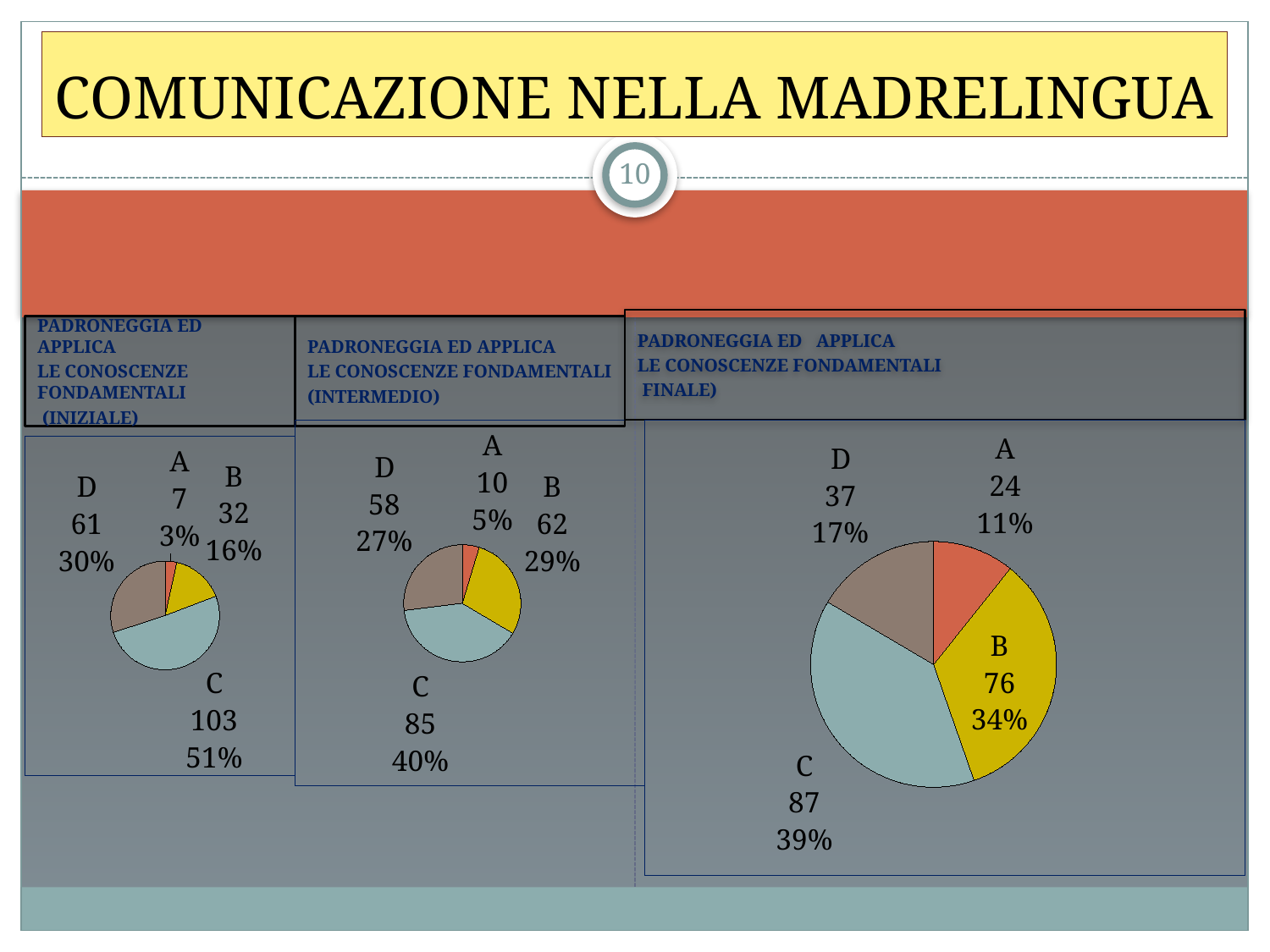
In the left pie chart (INIZIALE), what share of the pie does category D represent? 30% In the middle pie chart (INTERMEDIO), which category has the smallest value? A How many categories does the right pie chart (FINALE) show? 4 In the left pie chart (INIZIALE), what is the difference between the values for C and D? 42 In the middle pie chart (INTERMEDIO), what is the value for category B? 62 In the right pie chart (FINALE), what share of the pie does category B represent? 34% In the right pie chart (FINALE), what is the value for category D? 37 In the left pie chart (INIZIALE), what is the value for category C? 103 What type of chart is used in the middle panel (INTERMEDIO)? Pie chart In the middle pie chart (INTERMEDIO), which is larger, the value for B or the value for D? B In the right pie chart (FINALE), which category has the largest value? C How many pie charts are shown on the slide? 3